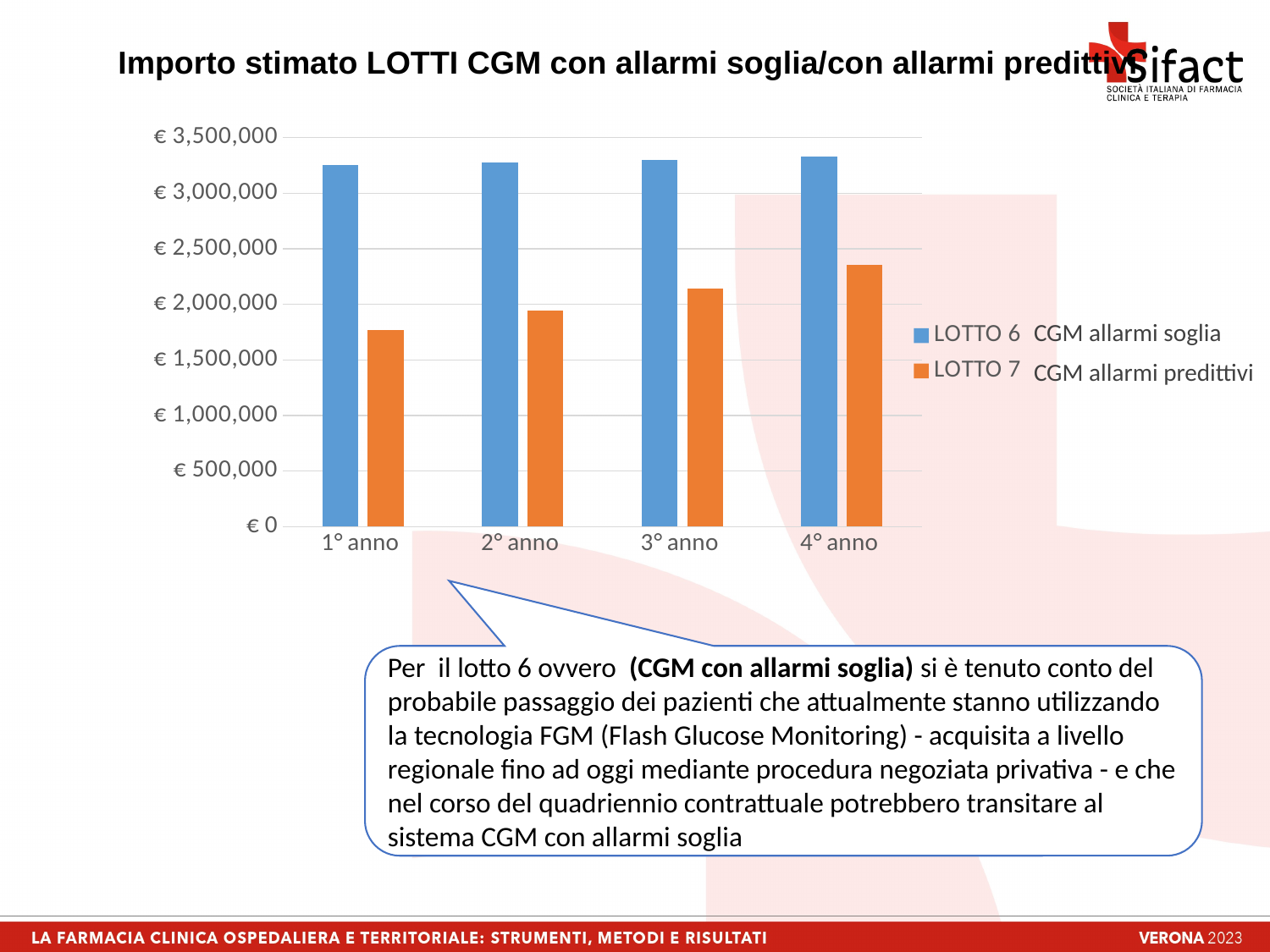
How many year categories are shown on the x axis? 4 How many series does the legend list? 2 Is the value for LOTTO 7 CGM allarmi predittivi in 1° anno greater or less than € 2,000,000? less In 1° anno, which is larger: LOTTO 6 CGM allarmi soglia or LOTTO 7 CGM allarmi predittivi? LOTTO 6 CGM allarmi soglia Which colour represents LOTTO 7 CGM allarmi predittivi in the chart? orange Is the value for LOTTO 7 CGM allarmi predittivi in 4° anno greater or less than € 2,000,000? greater Is the value for LOTTO 6 CGM allarmi soglia in 1° anno greater or less than € 3,000,000? greater Which year has the lowest value for LOTTO 7 CGM allarmi predittivi? 1° anno What kind of chart is shown on the slide? bar chart Do the values for LOTTO 7 CGM allarmi predittivi rise or fall from 1° anno to 4° anno? rise Which year has the highest value for LOTTO 7 CGM allarmi predittivi? 4° anno